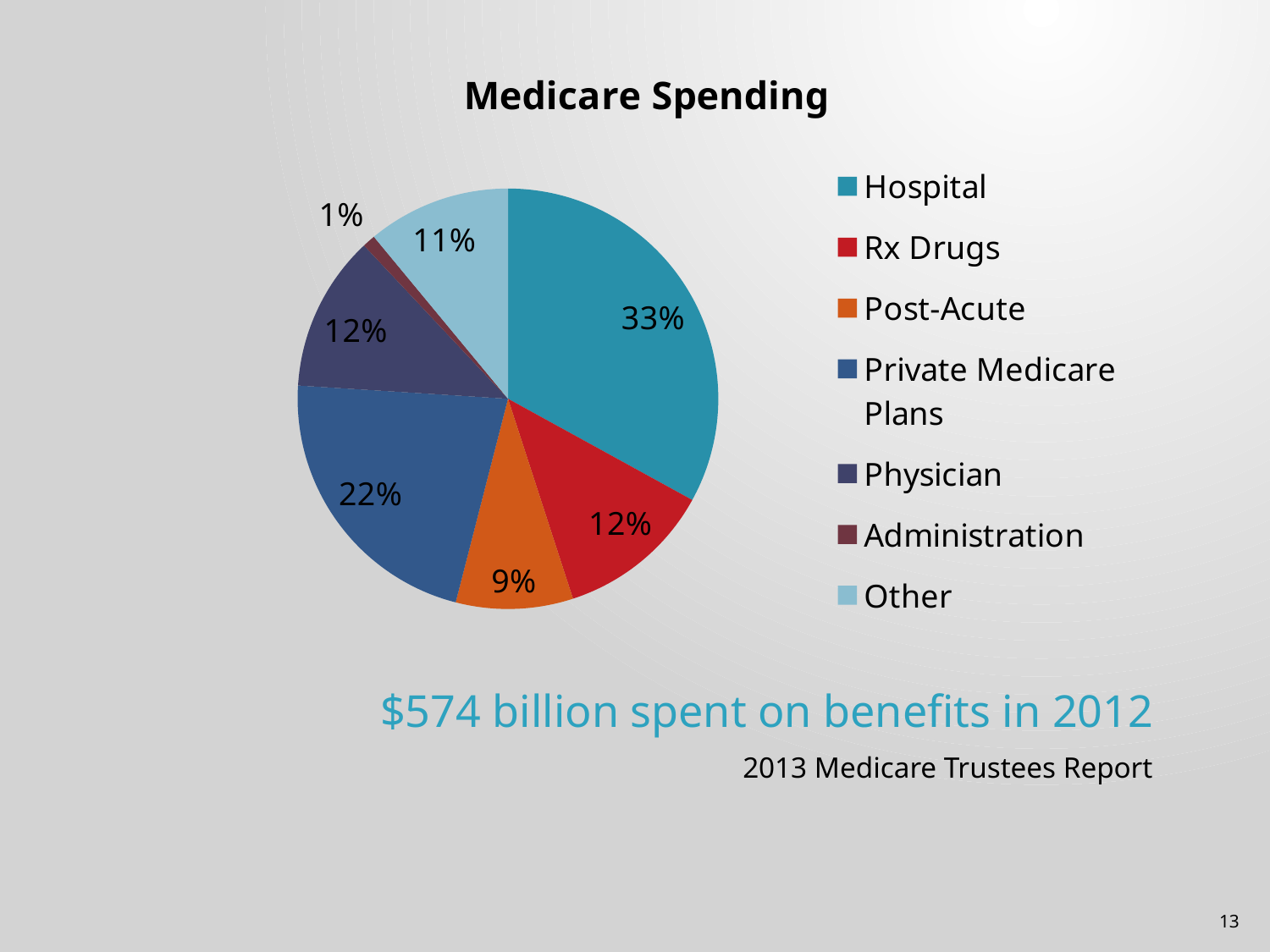
What is the title of the chart? Medicare Spending What is the difference in percentage points between Hospital and Private Medicare Plans? 11 How many categories does the pie chart show? 7 Which category has the largest slice of the pie? Hospital What type of chart is shown on the slide? Pie chart What percentage is shown for Administration? 1% What percentage of the pie is Private Medicare Plans? 22% What is the combined share of Rx Drugs and Physician? 24% Which is larger, the share for Other or the share for Post-Acute? Other What share does Post-Acute represent in the Medicare Spending chart? 9% Which category has the smallest slice of the pie? Administration What share of Medicare spending goes to Hospital? 33%